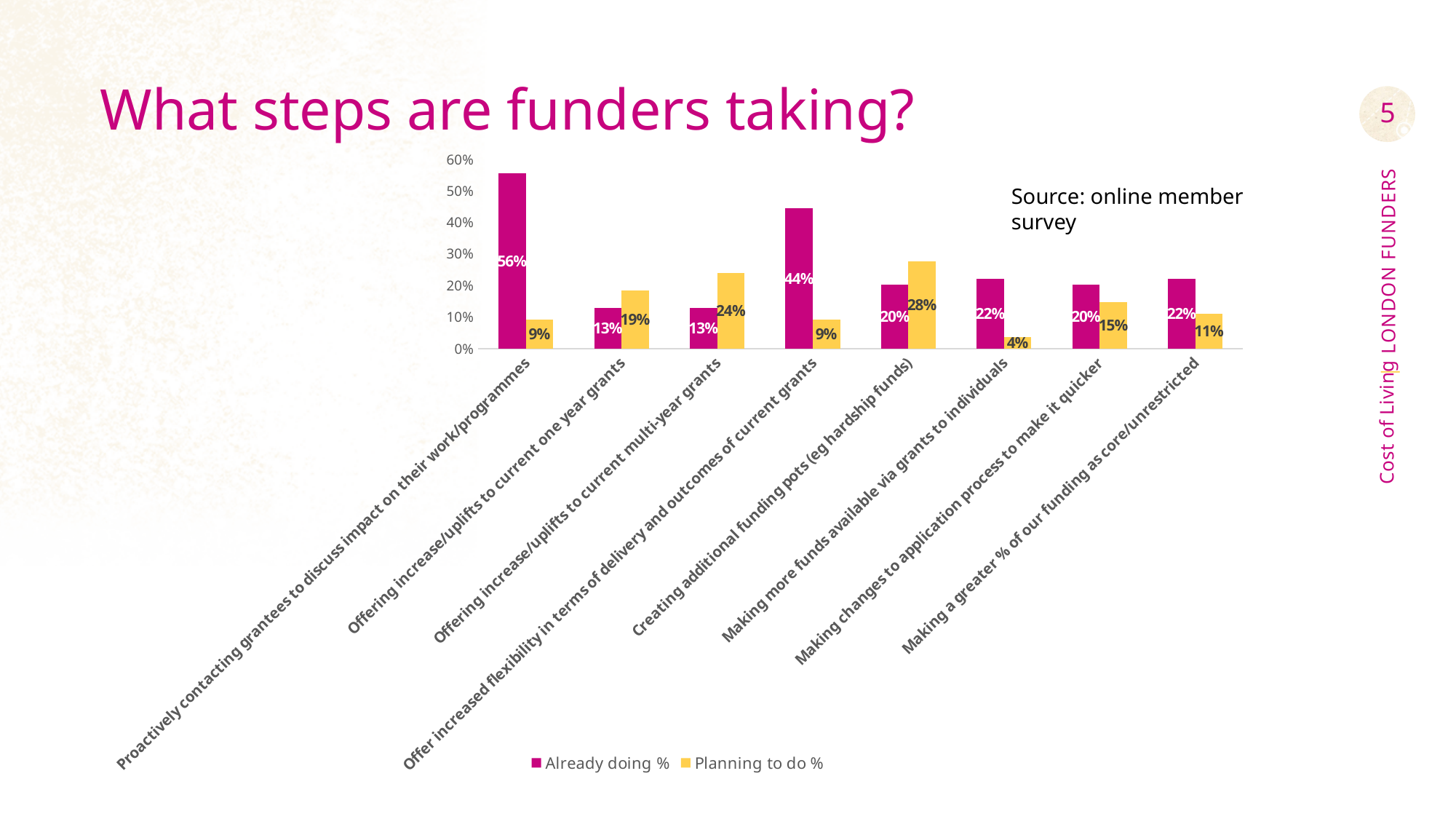
What is the difference between the 'Already doing %' and 'Planning to do %' values for 'Offer increased flexibility in terms of delivery and outcomes of current grants'? 35% How many series does the legend list? 2 Is the 'Already doing %' value for 'Offer increased flexibility in terms of delivery and outcomes of current grants' greater or less than 40%? greater What kind of chart is shown on the slide? Bar chart For 'Offering increase/uplifts to current multi-year grants', which is larger: 'Already doing %' or 'Planning to do %'? Planning to do % What is the 'Planning to do %' value for 'Creating additional funding pots (eg hardship funds)'? 28% What colour represents the 'Planning to do %' series in the chart? Yellow Which category has the highest 'Already doing %' value? Proactively contacting grantees to discuss impact on their work/programmes Which category has the lowest 'Planning to do %' value? Making more funds available via grants to individuals How many categories are shown on the x axis of the chart? 8 What is the 'Planning to do %' value for 'Making more funds available via grants to individuals'? 4% What is the 'Already doing %' value for 'Proactively contacting grantees to discuss impact on their work/programmes'? 56%